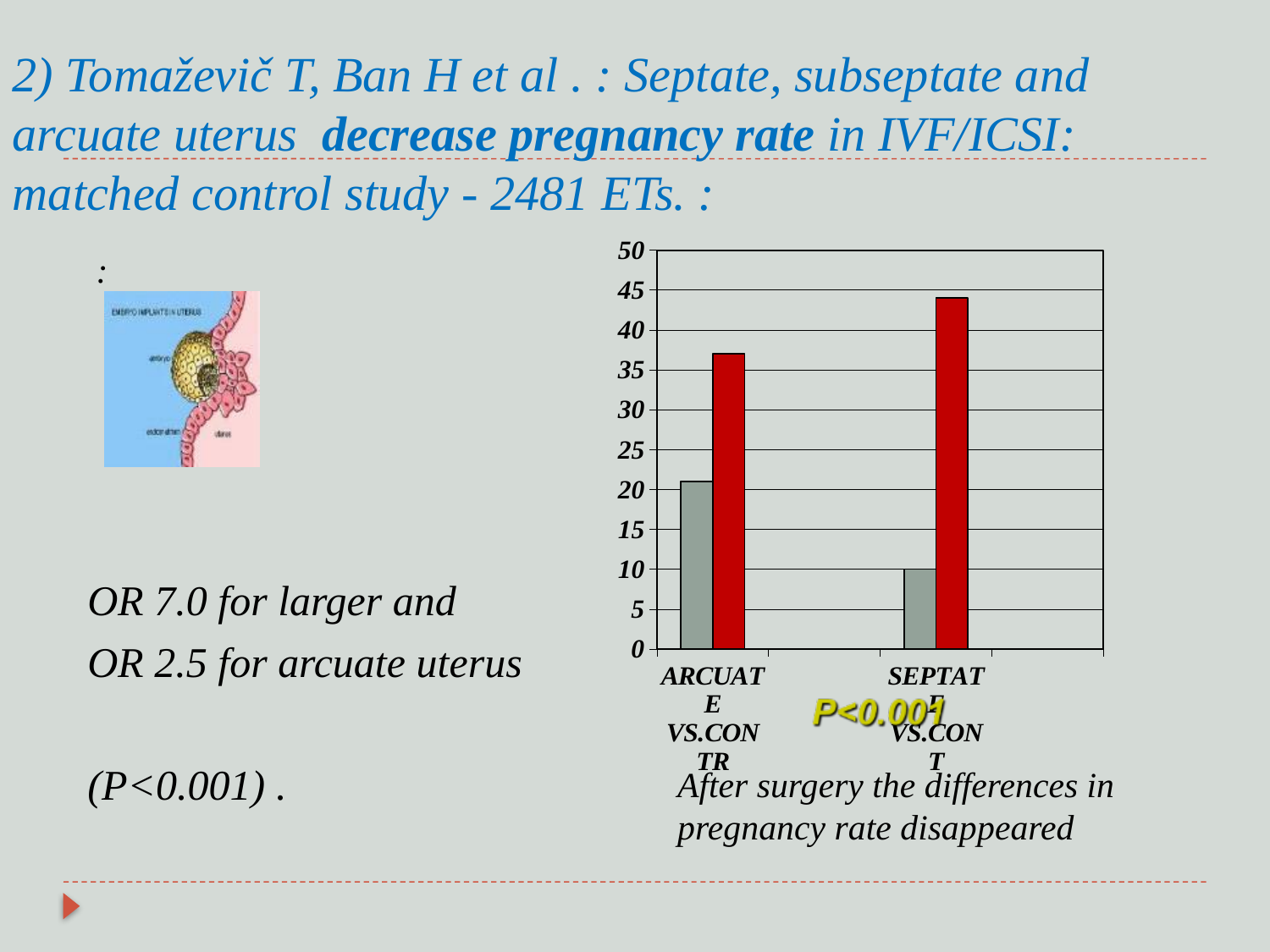
What kind of chart is shown on the slide? bar chart Is the value of the gray bar for SEPTATE greater or less than 15? less Which bar in the chart is the shortest? the gray bar for SEPTATE How many categories are shown on the x axis of the chart? 2 Is the value of the red bar for SEPTATE greater or less than 40? greater What is the highest value shown on the y axis of the chart? 50 Which category has the taller gray bar, ARCUATE or SEPTATE? ARCUATE Which category has the tallest red bar? SEPTATE In the ARCUATE category, which bar is taller, the red bar or the gray bar? the red bar Is the value of the red bar for ARCUATE greater or less than 35? greater What two colours are used for the bars in the chart? gray and red